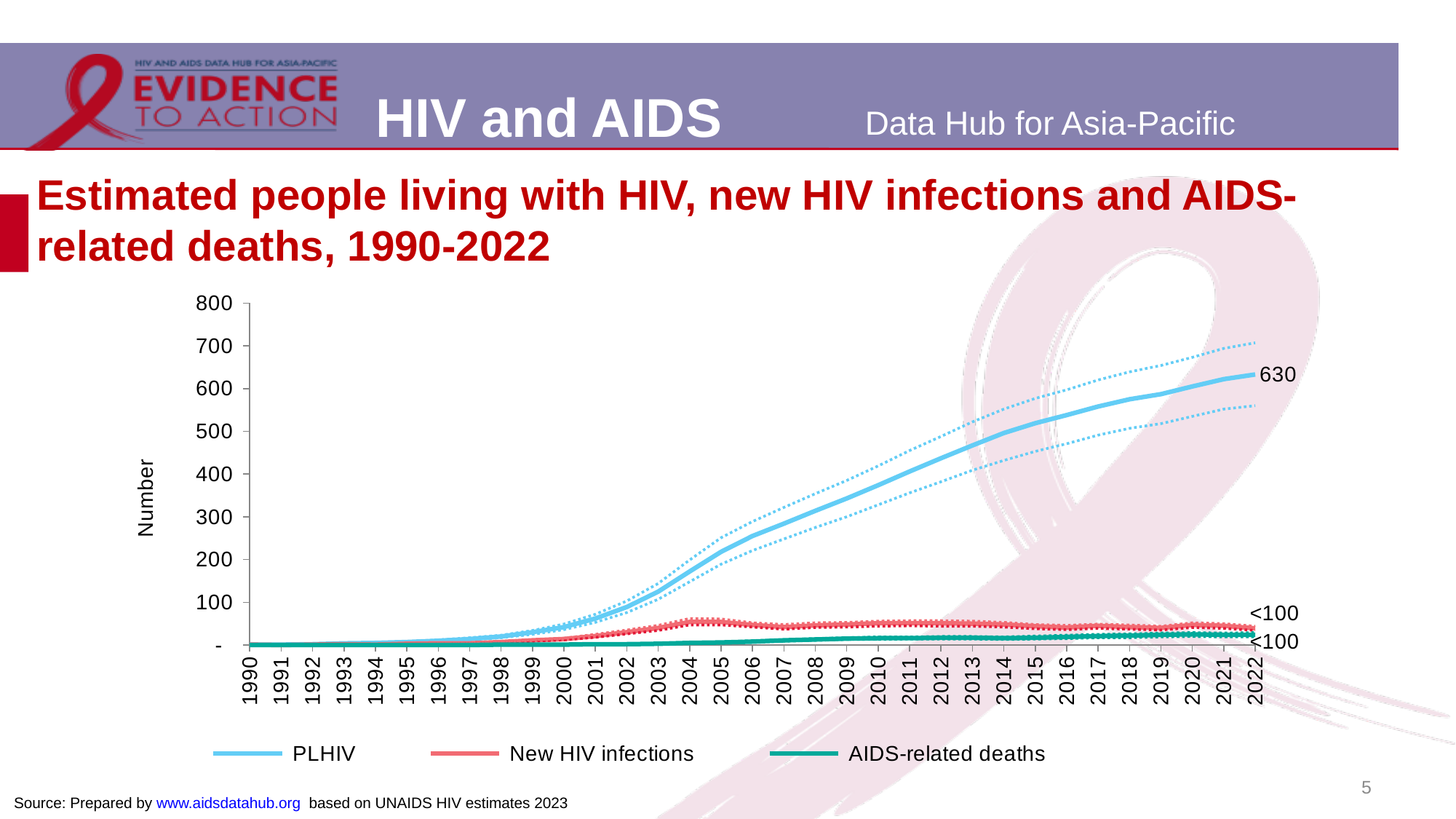
What is the estimated number of PLHIV in 2022 according to the data label? 630 Is the PLHIV value in 2000 greater or less than 100? less What is the label on the vertical axis? Number Which series has the highest value in 2022? PLHIV What type of chart is shown on the slide? line chart Is the PLHIV value in 2022 greater or less than 600? greater What is the data label shown for AIDS-related deaths in 2022? <100 How many series does the legend list? 3 Which is larger in 2022, PLHIV or New HIV infections? PLHIV What is the data label shown for New HIV infections in 2022? <100 Is the PLHIV value in 2010 greater or less than 300? greater Does the PLHIV line rise or fall from 1990 to 2022? rise